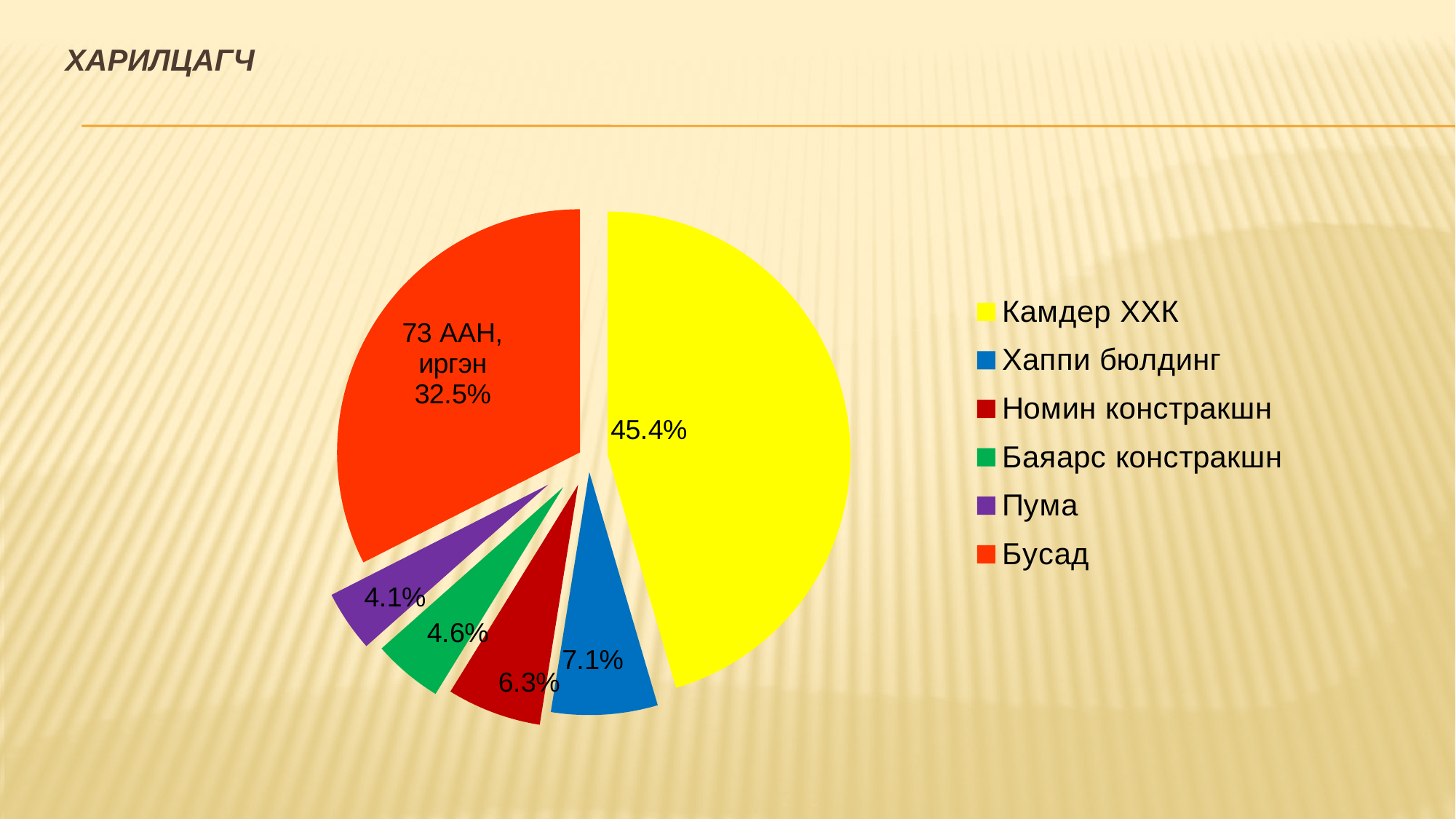
Which category has the smallest slice of the pie? Пума What share of the pie does Хаппи бюлдинг have? 7.1% How many categories does the legend list? 6 What share of the pie does Номин констракшн have? 6.3% Which is larger, the share of Хаппи бюлдинг or the share of Номин констракшн? Хаппи бюлдинг What share of the pie does Пума have? 4.1% Which category has the largest slice of the pie? Камдер ХХК What kind of chart is shown on the slide? pie chart What share of the pie does Камдер ХХК have? 45.4% What share of the pie does Бусад have? 32.5% What is the difference between the shares of Камдер ХХК and Бусад? 12.9% What share of the pie does Баяарс констракшн have? 4.6%